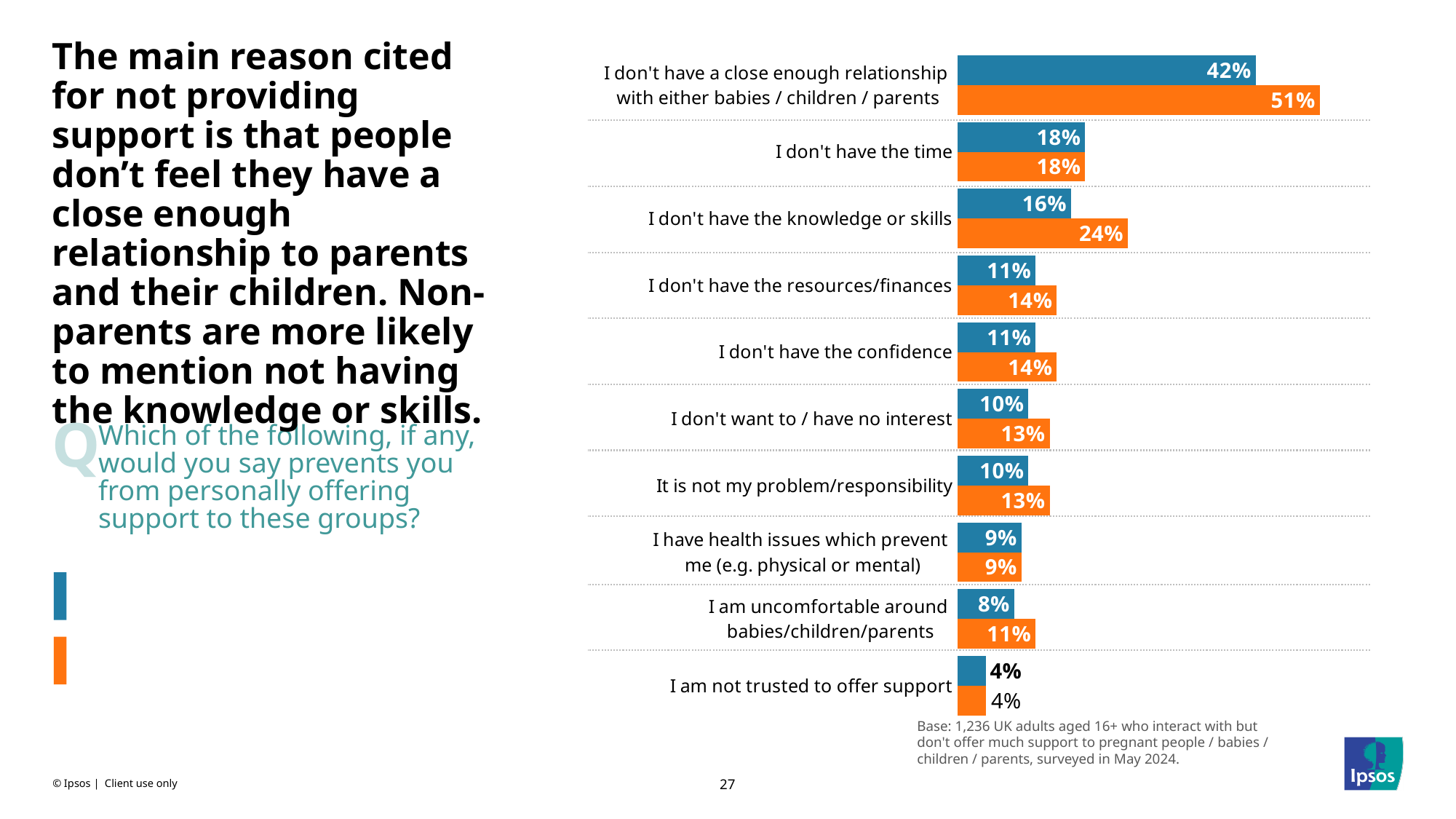
Which is larger: the blue bar for "I don't have the time" or the blue bar for "I don't have the resources/finances"? I don't have the time What is the difference between the orange and blue bars for "I don't have the knowledge or skills"? 8 percentage points Which reason has the lowest value for the orange series? I am not trusted to offer support How many series (bar colours) does the chart show? 2 How many reasons (categories) are listed in the chart? 10 What is the difference between the orange and blue bars for "I don't have a close enough relationship with either babies / children / parents"? 9 percentage points What is the value of the orange bar for "I don't have the knowledge or skills"? 24% What is the value of the blue bar for "I am uncomfortable around babies/children/parents"? 8% What kind of chart is shown on the slide? bar chart Which reason has the highest value for the blue series? I don't have a close enough relationship with either babies / children / parents What is the value of the blue bar for "I don't have the knowledge or skills"? 16% What is the value of the orange bar for "I don't have a close enough relationship with either babies / children / parents"? 51%